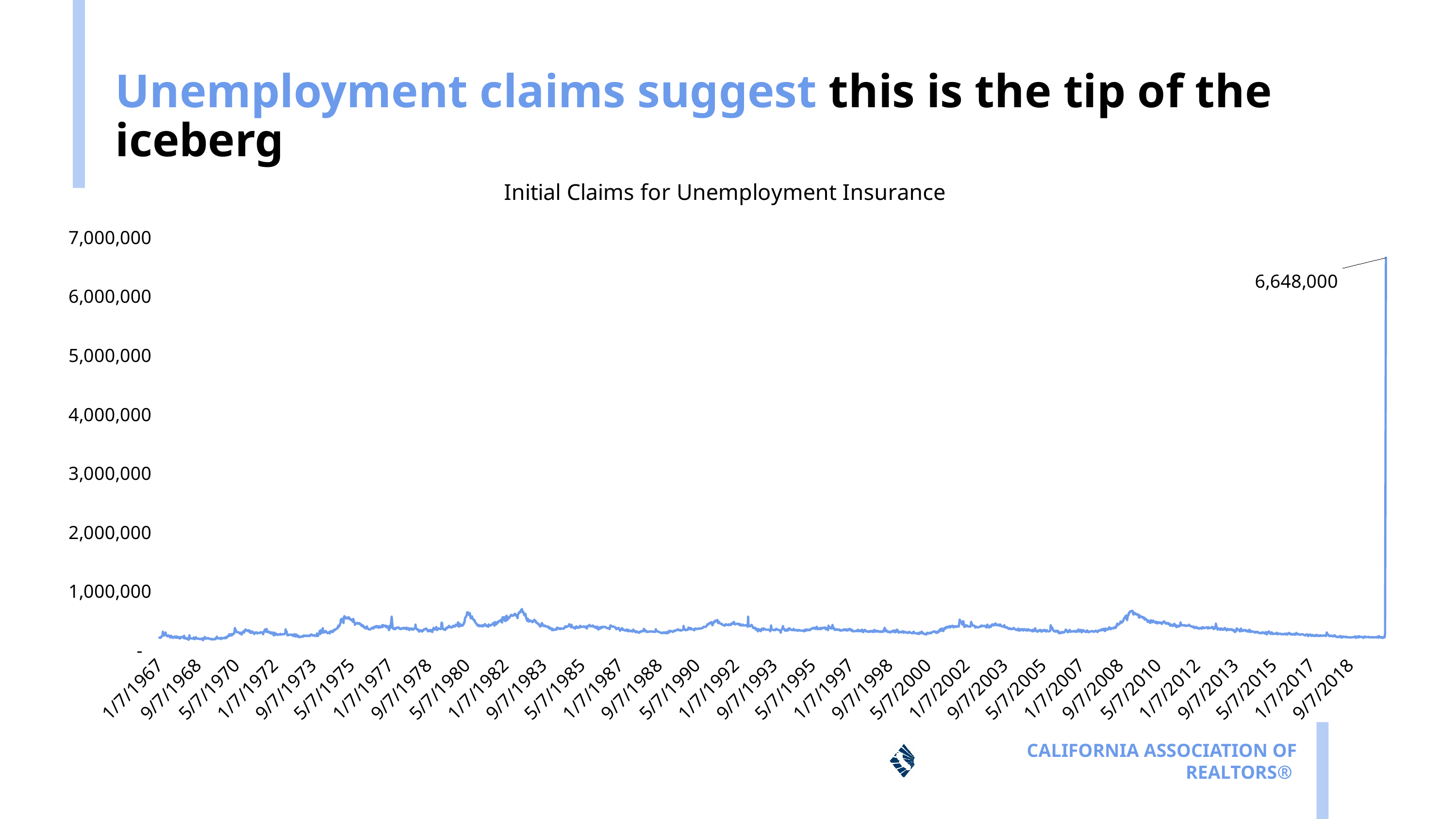
Is the value at 9/7/2008 greater or less than 1,000,000? less What is the title of the chart? Initial Claims for Unemployment Insurance Where does the line reach its highest value: at the start of the x axis or at the end? at the end What is the highest tick label shown on the y axis? 7,000,000 What value is printed as the data label at the final point of the line? 6,648,000 How many data labels are printed on the line? 1 What kind of chart is shown on the slide? line chart Which is larger: the value at the final point of the line or the value at 9/7/2018? the final point Is the highest value on the chart greater or less than 6,000,000? greater Is the value at 5/7/2010 greater or less than 2,000,000? less How does the line behave at the far right end of the x axis: does it rise sharply or fall sharply? rises sharply